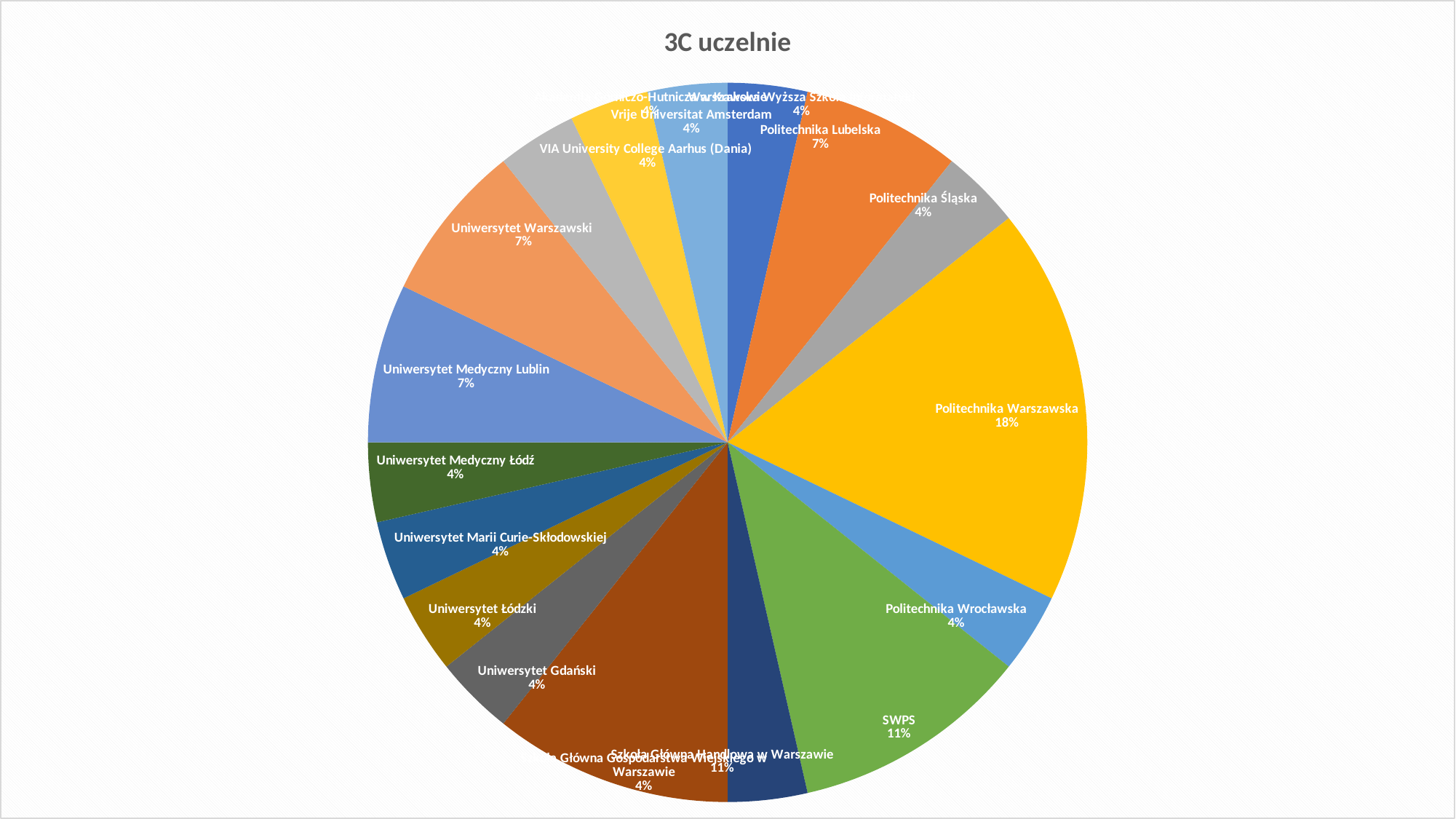
What share of the pie does Politechnika Warszawska have? 18% What is the difference in percentage points between Uniwersytet Warszawski and Uniwersytet Łódzki? 3 What percentage is shown for SWPS? 11% What is the title of the chart? 3C uczelnie What type of chart is shown on the slide? pie chart What percentage is shown for Uniwersytet Medyczny Lublin? 7% What percentage is shown for Uniwersytet Gdański? 4% What percentage is shown for Politechnika Śląska? 4% Which university has the largest slice of the pie? Politechnika Warszawska What percentage is shown for Politechnika Lubelska? 7% Which is larger, the share for Uniwersytet Warszawski or the share for Politechnika Wrocławska? Uniwersytet Warszawski What is the difference in percentage points between Politechnika Warszawska and SWPS? 7